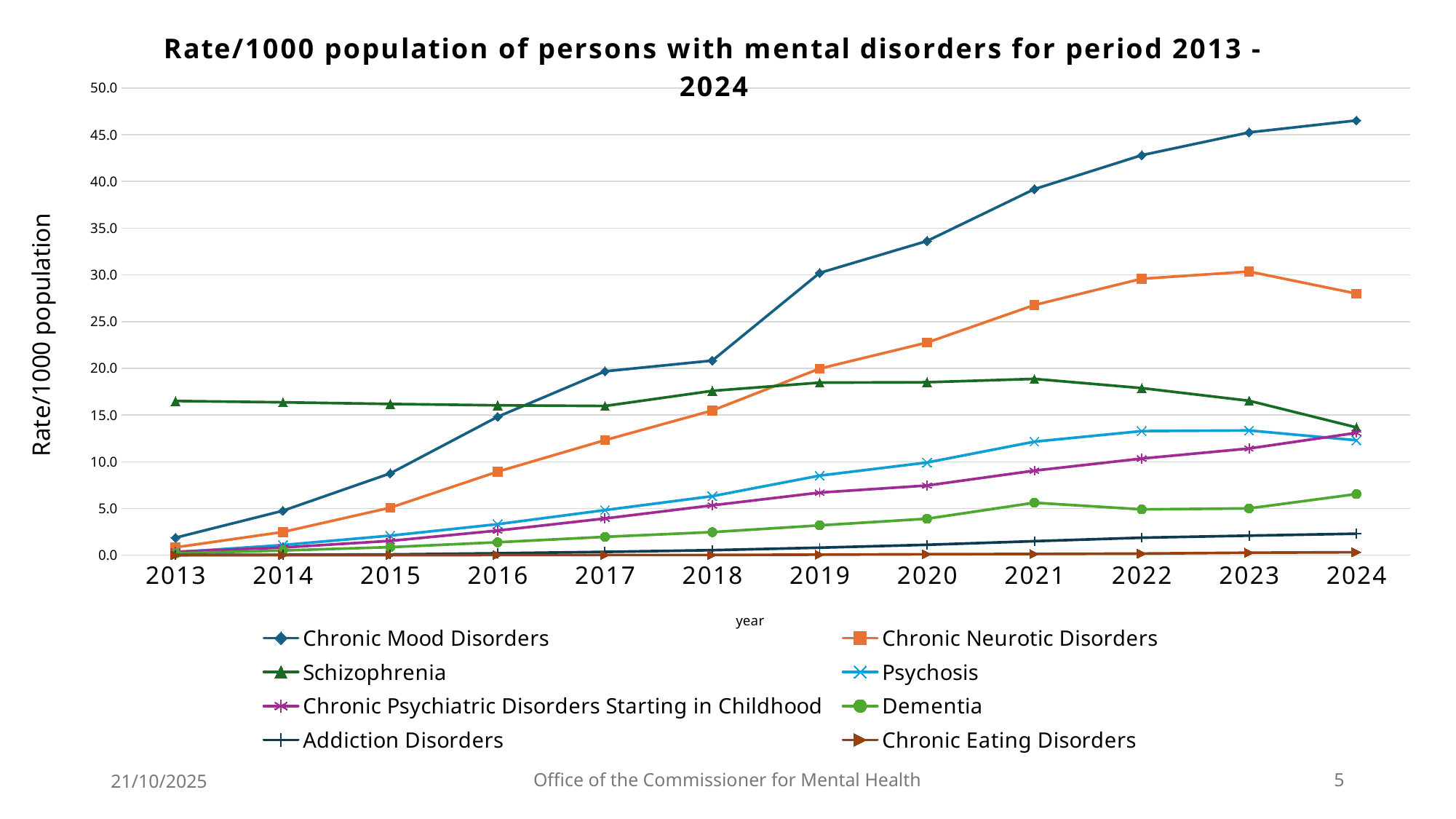
What is the label on the y axis? Rate/1000 population Is the value for Psychosis in 2022 greater or less than 10.0? greater Which series has the highest value in 2024? Chronic Mood Disorders How many years are plotted along the x axis? 12 Is the value for Chronic Mood Disorders in 2024 greater or less than 45.0? greater What kind of chart is shown on the slide? line chart Does the Chronic Mood Disorders line rise or fall from 2013 to 2024? rise In 2024, which is larger: Dementia or Addiction Disorders? Dementia Which series has the lowest value in 2024? Chronic Eating Disorders How many series does the legend list? 8 In 2013, which is larger: Schizophrenia or Chronic Mood Disorders? Schizophrenia Is the value for Chronic Neurotic Disorders in 2024 greater or less than 30.0? less